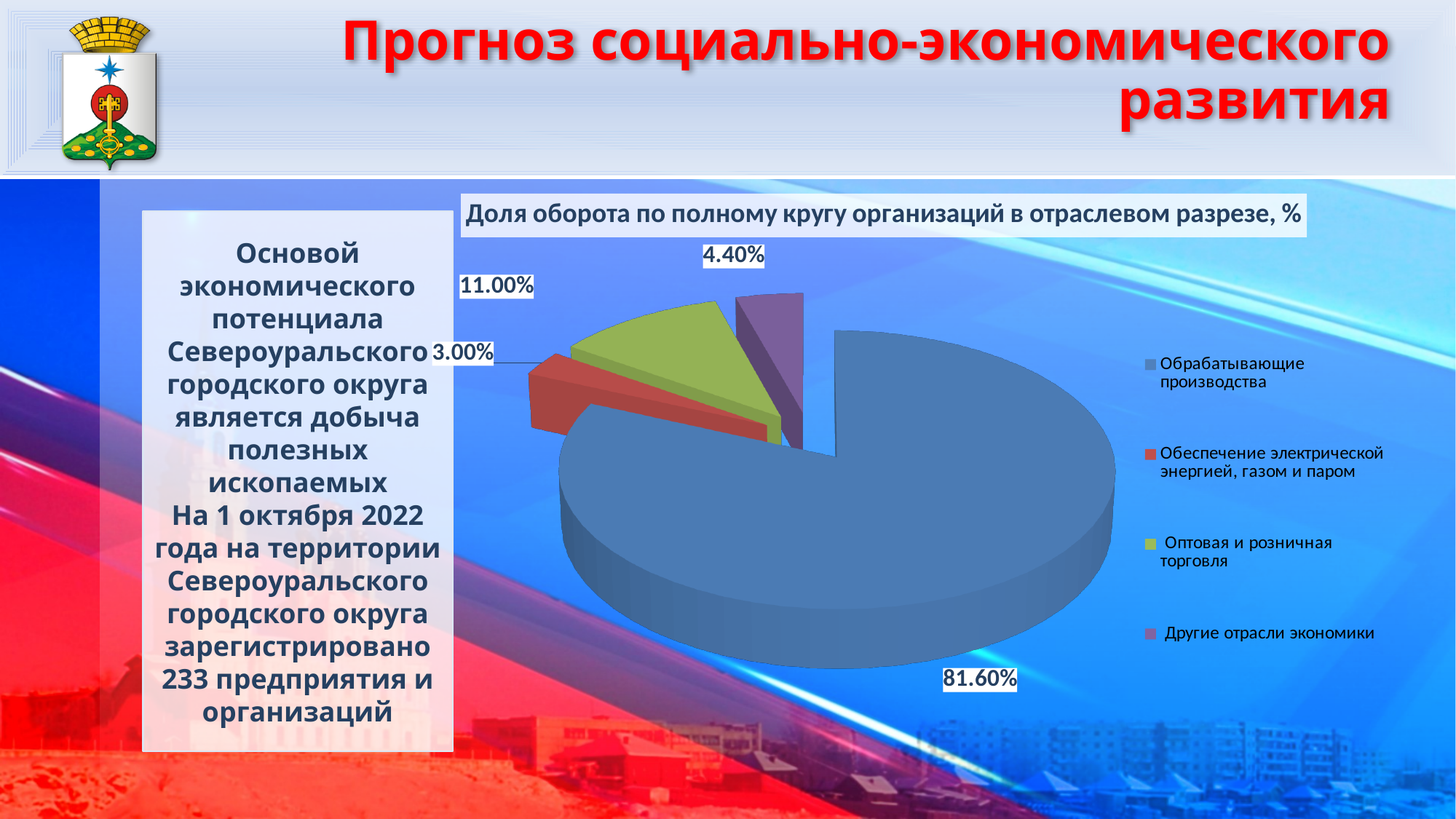
What is the difference between the shares of Оптовая и розничная торговля and Другие отрасли экономики? 6.60% Which category has the smallest share of the pie? Обеспечение электрической энергией, газом и паром What colour is the slice for Оптовая и розничная торговля? Green How many categories does the pie chart show? 4 What type of chart is shown on the slide? Pie chart What is the title of the pie chart? Доля оборота по полному кругу организаций в отраслевом разрезе, % Which is larger: the share of Другие отрасли экономики or the share of Обеспечение электрической энергией, газом и паром? Другие отрасли экономики Which category has the largest share of the pie? Обрабатывающие производства What is the share for Другие отрасли экономики? 4.40% What is the share for Обеспечение электрической энергией, газом и паром? 3.00% What is the share for Оптовая и розничная торговля? 11.00% What is the share for Обрабатывающие производства? 81.60%